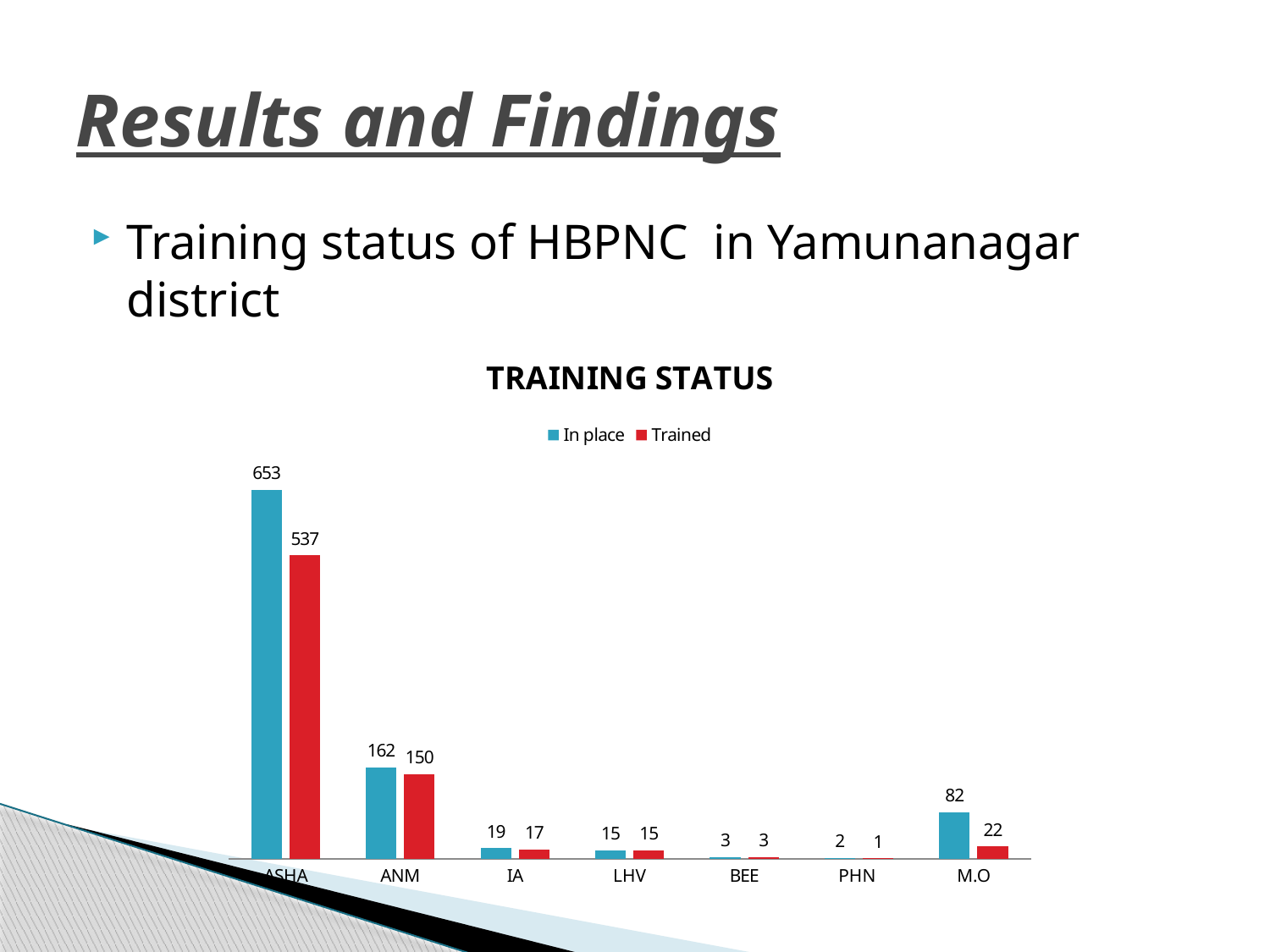
What kind of chart is shown? Bar chart Which category has the highest 'In place' value? ASHA How many series does the legend list? 2 What is the 'Trained' value for ANM? 150 What is the 'In place' value for ASHA? 653 What is the difference between the 'In place' and 'Trained' values for M.O? 60 What is the 'Trained' value for M.O? 22 Which category has the lowest 'Trained' value? PHN How many categories are shown on the x axis? 7 Which is larger, the 'In place' value for ANM or the 'In place' value for M.O? ANM What is the title of the chart? TRAINING STATUS What is the difference between the 'In place' and 'Trained' values for ASHA? 116